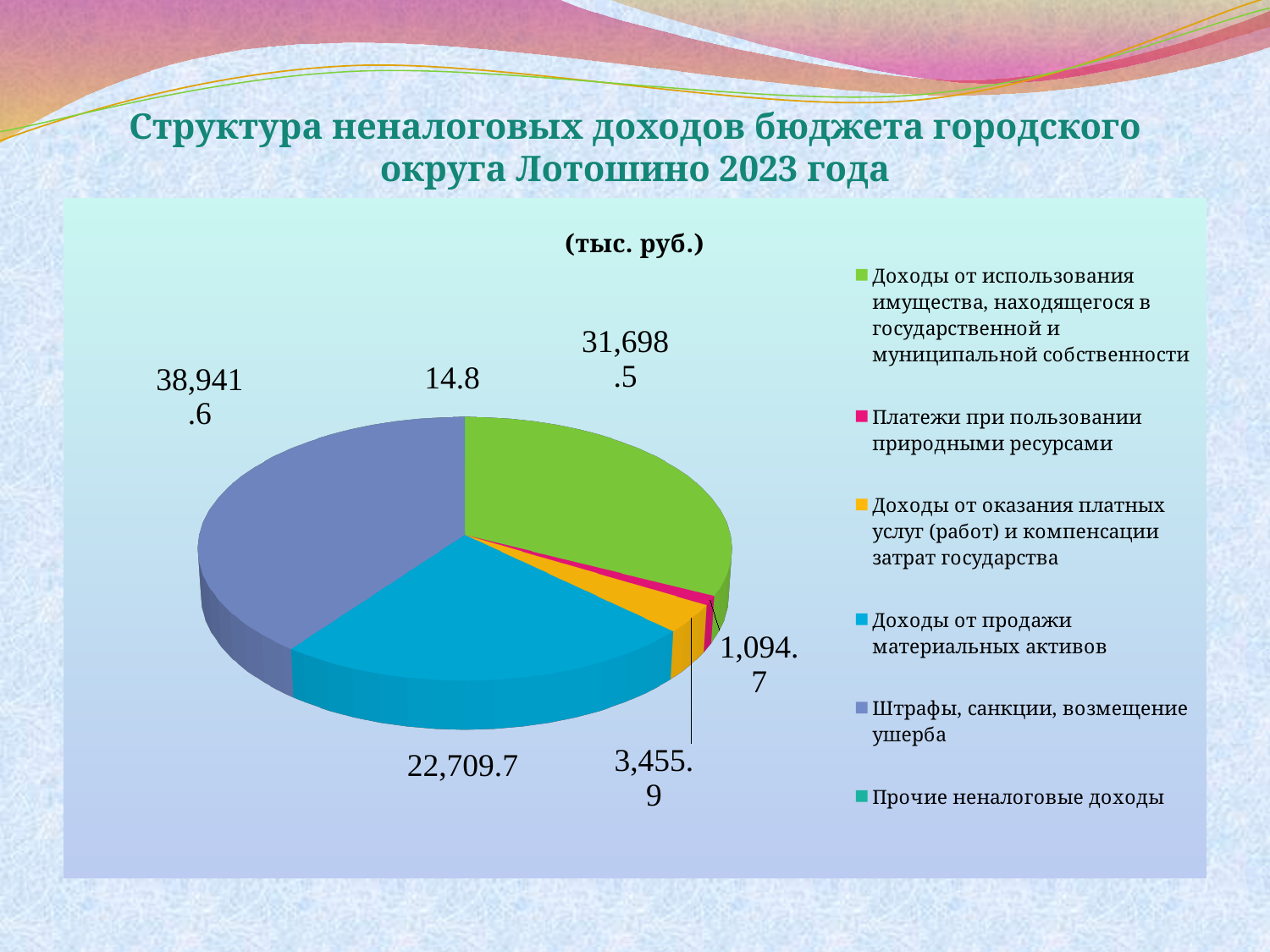
What is the value for «Штрафы, санкции, возмещение ущерба»? 38,941.6 What unit is given in the chart title above the pie? тыс. руб. How many categories does the legend of the pie chart list? 6 What is the value for «Доходы от использования имущества, находящегося в государственной и муниципальной собственности»? 31,698.5 What is the value for «Доходы от продажи материальных активов»? 22,709.7 Which is larger: «Доходы от продажи материальных активов» or «Доходы от оказания платных услуг (работ) и компенсации затрат государства»? Доходы от продажи материальных активов What kind of chart is shown on the slide? Pie chart Which category has the smallest value in the pie chart? Прочие неналоговые доходы What is the value for «Прочие неналоговые доходы»? 14.8 Which category has the largest slice of the pie? Штрафы, санкции, возмещение ущерба What is the difference between the values for «Штрафы, санкции, возмещение ущерба» and «Доходы от использования имущества, находящегося в государственной и муниципальной собственности»? 7,243.1 What is the value for «Платежи при пользовании природными ресурсами»? 1,094.7